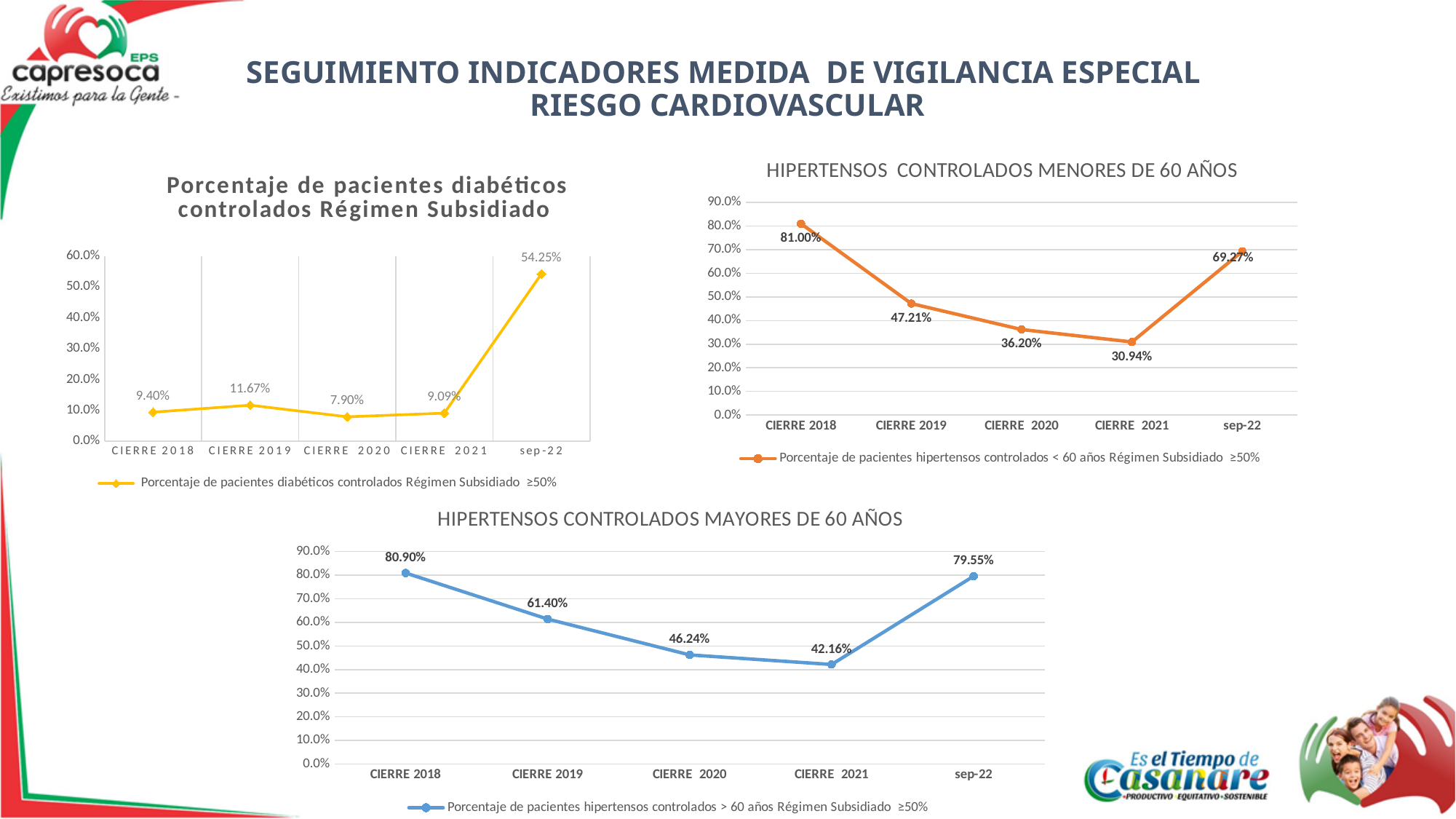
In the 'HIPERTENSOS CONTROLADOS MAYORES DE 60 AÑOS' chart, do the values rise or fall from CIERRE 2018 to CIERRE 2021? Fall In the 'Porcentaje de pacientes diabéticos controlados Régimen Subsidiado' chart, what is the value for sep-22? 54.25% In the 'HIPERTENSOS CONTROLADOS MAYORES DE 60 AÑOS' chart, which category has the lowest value? CIERRE 2021 In the 'HIPERTENSOS CONTROLADOS MENORES DE 60 AÑOS' chart, which category has the highest value? CIERRE 2018 In the 'HIPERTENSOS CONTROLADOS MENORES DE 60 AÑOS' chart, how many data points are plotted? 5 In the 'HIPERTENSOS CONTROLADOS MAYORES DE 60 AÑOS' chart, which is larger, the value for CIERRE 2020 or the value for sep-22? sep-22 In the 'HIPERTENSOS CONTROLADOS MENORES DE 60 AÑOS' chart, what is the difference between the values for CIERRE 2018 and sep-22? 11.73% What kind of chart is the 'HIPERTENSOS CONTROLADOS MAYORES DE 60 AÑOS' chart? Line chart In the 'Porcentaje de pacientes diabéticos controlados Régimen Subsidiado' chart, what is the difference between the values for CIERRE 2019 and CIERRE 2018? 2.27% In the 'HIPERTENSOS CONTROLADOS MENORES DE 60 AÑOS' chart, what is the value for CIERRE 2021? 30.94% In the 'Porcentaje de pacientes diabéticos controlados Régimen Subsidiado' chart, which category has the lowest value? CIERRE 2020 In the 'HIPERTENSOS CONTROLADOS MAYORES DE 60 AÑOS' chart, what is the value for CIERRE 2019? 61.40%